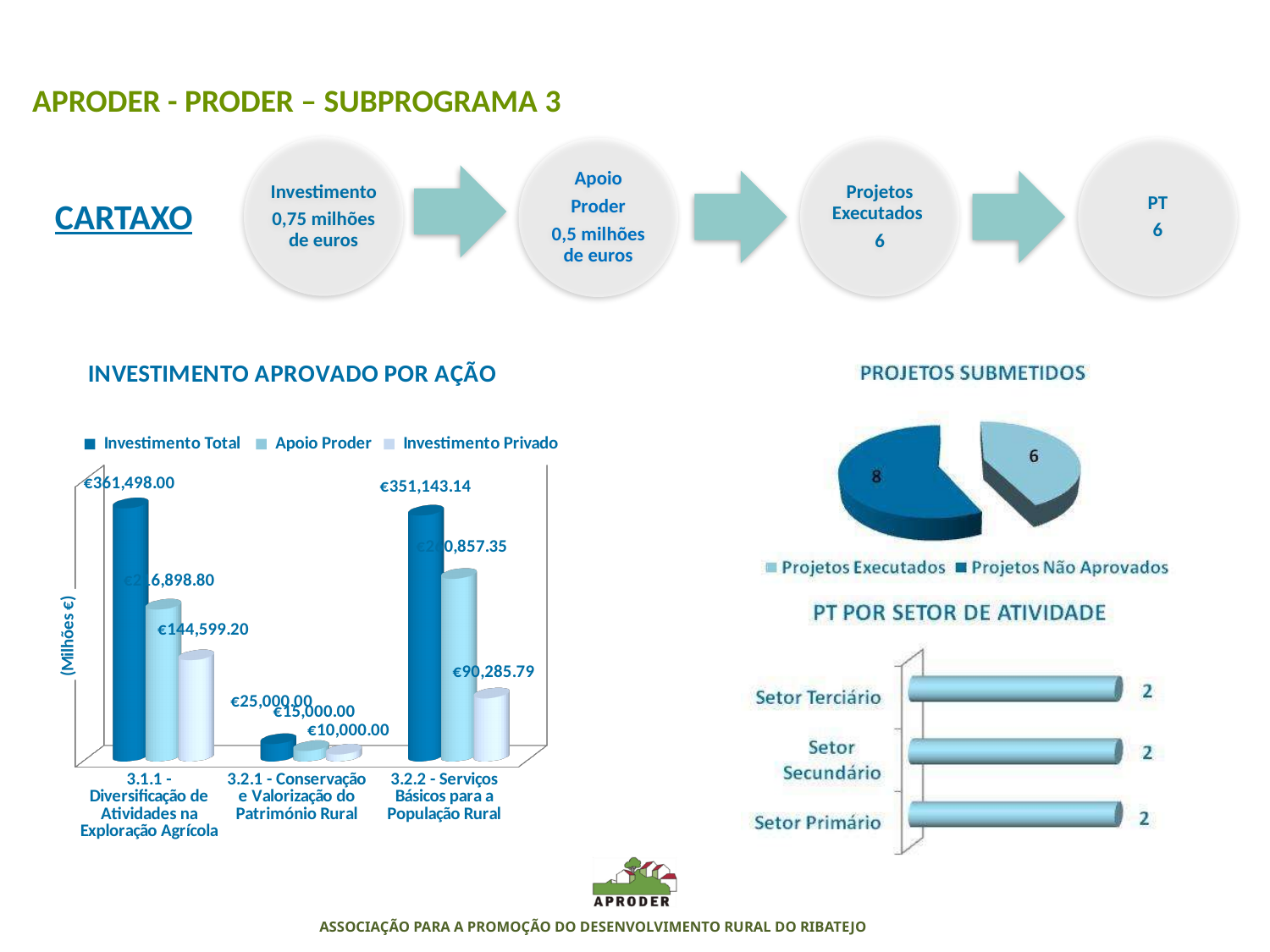
In the 'INVESTIMENTO APROVADO POR AÇÃO' chart, which action has the lowest Investimento Total? 3.2.1 - Conservação e Valorização do Património Rural How many actions (categories) are shown in the 'INVESTIMENTO APROVADO POR AÇÃO' chart? 3 In the 'INVESTIMENTO APROVADO POR AÇÃO' chart, what is the Investimento Privado for 3.2.2 - Serviços Básicos para a População Rural? €90,285.79 In the 'INVESTIMENTO APROVADO POR AÇÃO' chart, which is larger: the Investimento Privado for 3.1.1 or the Investimento Privado for 3.2.2? 3.1.1 - Diversificação de Atividades na Exploração Agrícola In the 'INVESTIMENTO APROVADO POR AÇÃO' chart, what is the Investimento Total for 3.1.1 - Diversificação de Atividades na Exploração Agrícola? €361,498.00 What kind of chart is 'PT POR SETOR DE ATIVIDADE'? Bar chart In the 'PROJETOS SUBMETIDOS' pie chart, how many Projetos Não Aprovados are there? 8 In the 'INVESTIMENTO APROVADO POR AÇÃO' chart, what is the Apoio Proder value for 3.2.1 - Conservação e Valorização do Património Rural? €15,000.00 In the 'PROJETOS SUBMETIDOS' pie chart, which slice is larger: Projetos Executados or Projetos Não Aprovados? Projetos Não Aprovados In the 'INVESTIMENTO APROVADO POR AÇÃO' chart, what is the difference between the Investimento Total and the Investimento Privado for 3.2.1 - Conservação e Valorização do Património Rural? €15,000.00 In the 'PT POR SETOR DE ATIVIDADE' chart, what is the value for Setor Secundário? 2 How many series does the legend of the 'INVESTIMENTO APROVADO POR AÇÃO' chart list? 3